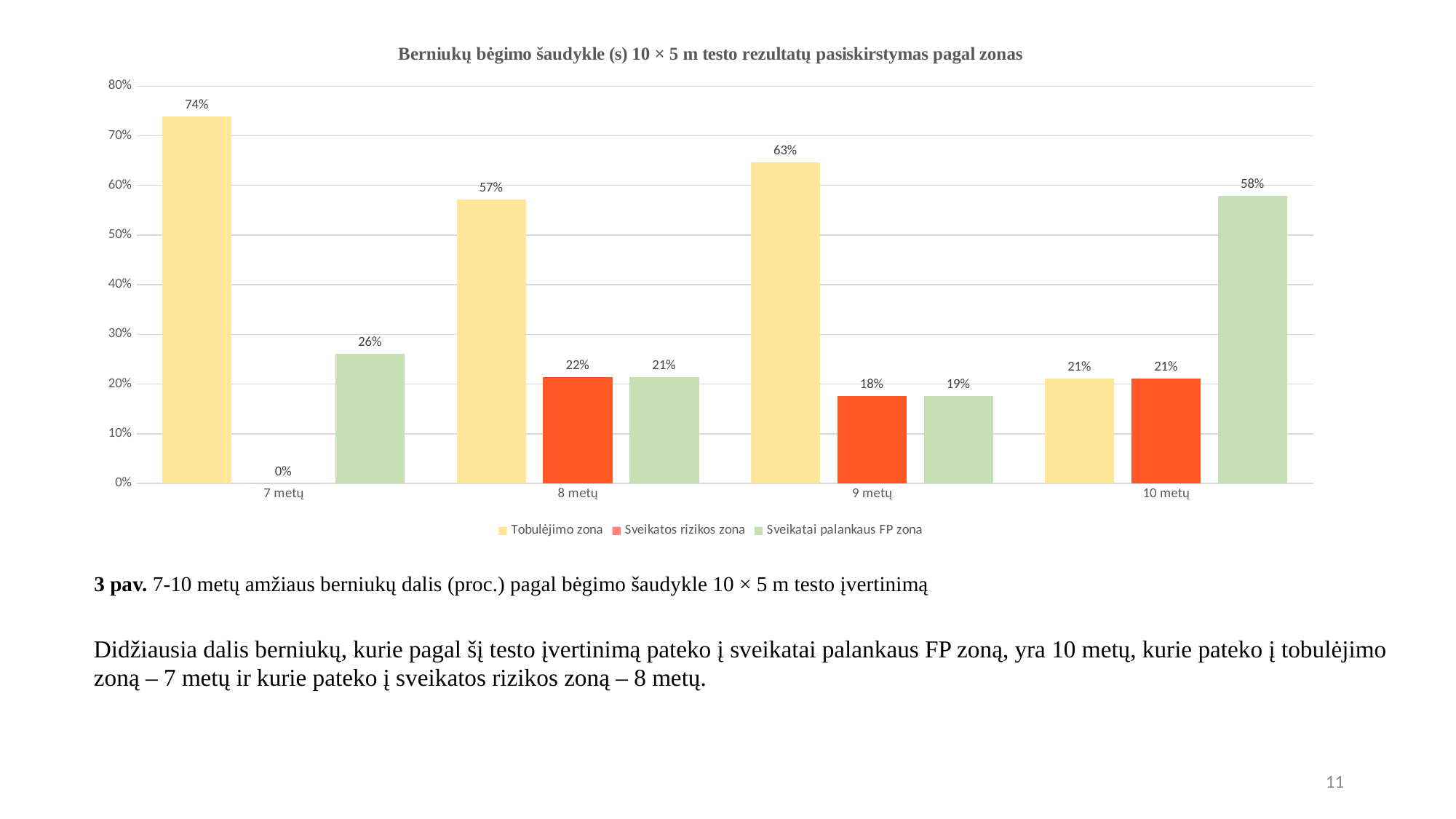
Which is larger: Tobulėjimo zona for 9 metų or Sveikatai palankaus FP zona for 10 metų? Tobulėjimo zona for 9 metų What is the value for Sveikatos rizikos zona for 7 metų? 0% How many series does the legend list? 3 What is the title of the chart? Berniukų bėgimo šaudykle (s) 10 × 5 m testo rezultatų pasiskirstymas pagal zonas Which age group has the highest value for Tobulėjimo zona? 7 metų What type of chart is shown on the slide? bar chart What is the value for Sveikatos rizikos zona for 8 metų? 22% How many age groups are shown on the x axis? 4 What is the difference between the Tobulėjimo zona values for 7 metų and 10 metų? 53% Which age group has the lowest value for Sveikatai palankaus FP zona? 9 metų What is the value for Sveikatai palankaus FP zona for 10 metų? 58% What is the value for Tobulėjimo zona for 7 metų? 74%